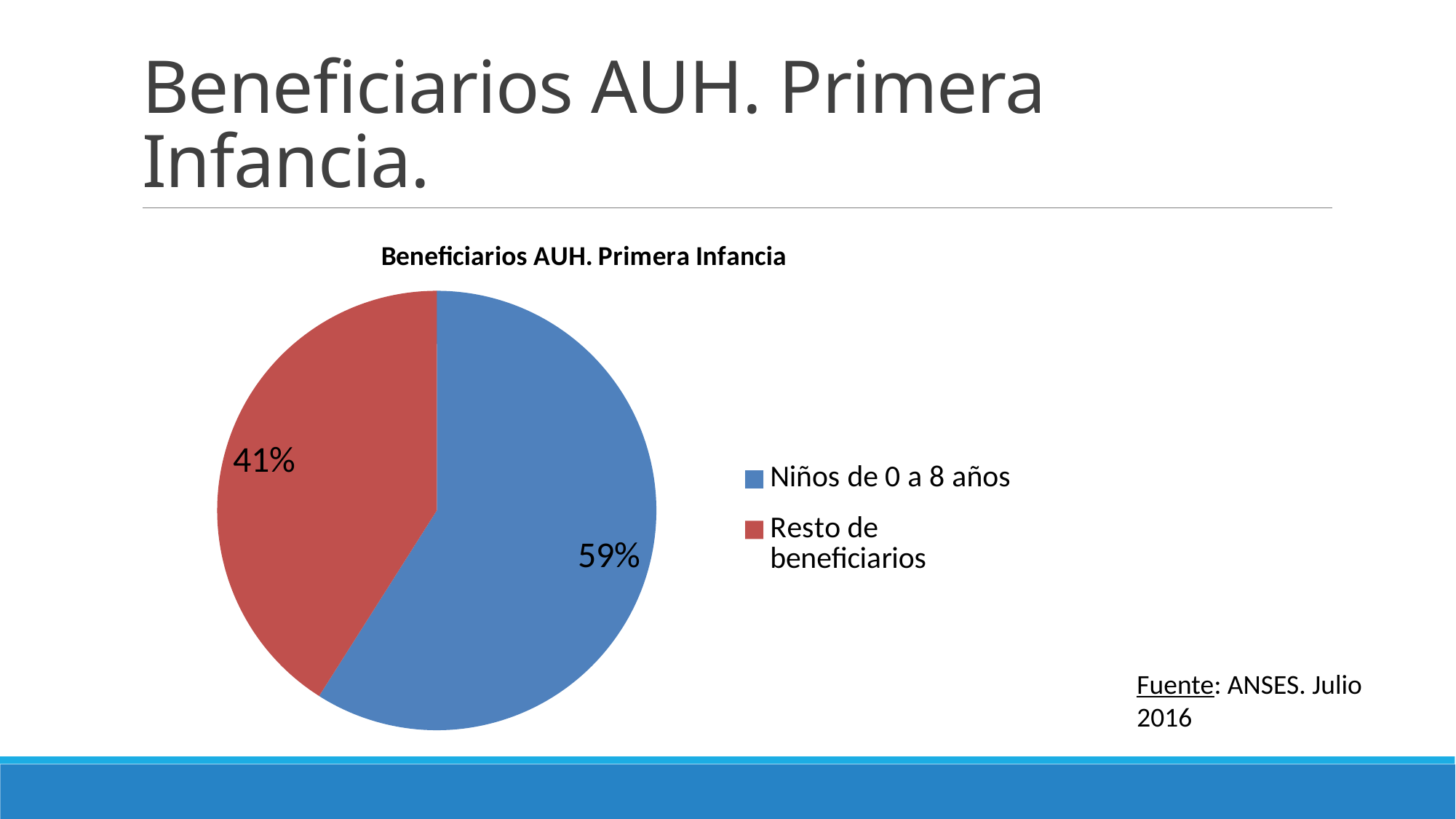
What is the title of the chart? Beneficiarios AUH. Primera Infancia What is the difference in percentage points between the "Niños de 0 a 8 años" slice and the "Resto de beneficiarios" slice? 18 percentage points Which is larger: the share for "Niños de 0 a 8 años" or the share for "Resto de beneficiarios"? Niños de 0 a 8 años How many categories are shown in the pie chart? 2 Which category has the largest slice of the pie? Niños de 0 a 8 años What kind of chart is shown on the slide? Pie chart Which category has the smallest slice of the pie? Resto de beneficiarios What share of the pie does "Resto de beneficiarios" represent? 41% What colour is the slice for "Resto de beneficiarios"? Red What share of the pie does "Niños de 0 a 8 años" represent? 59%